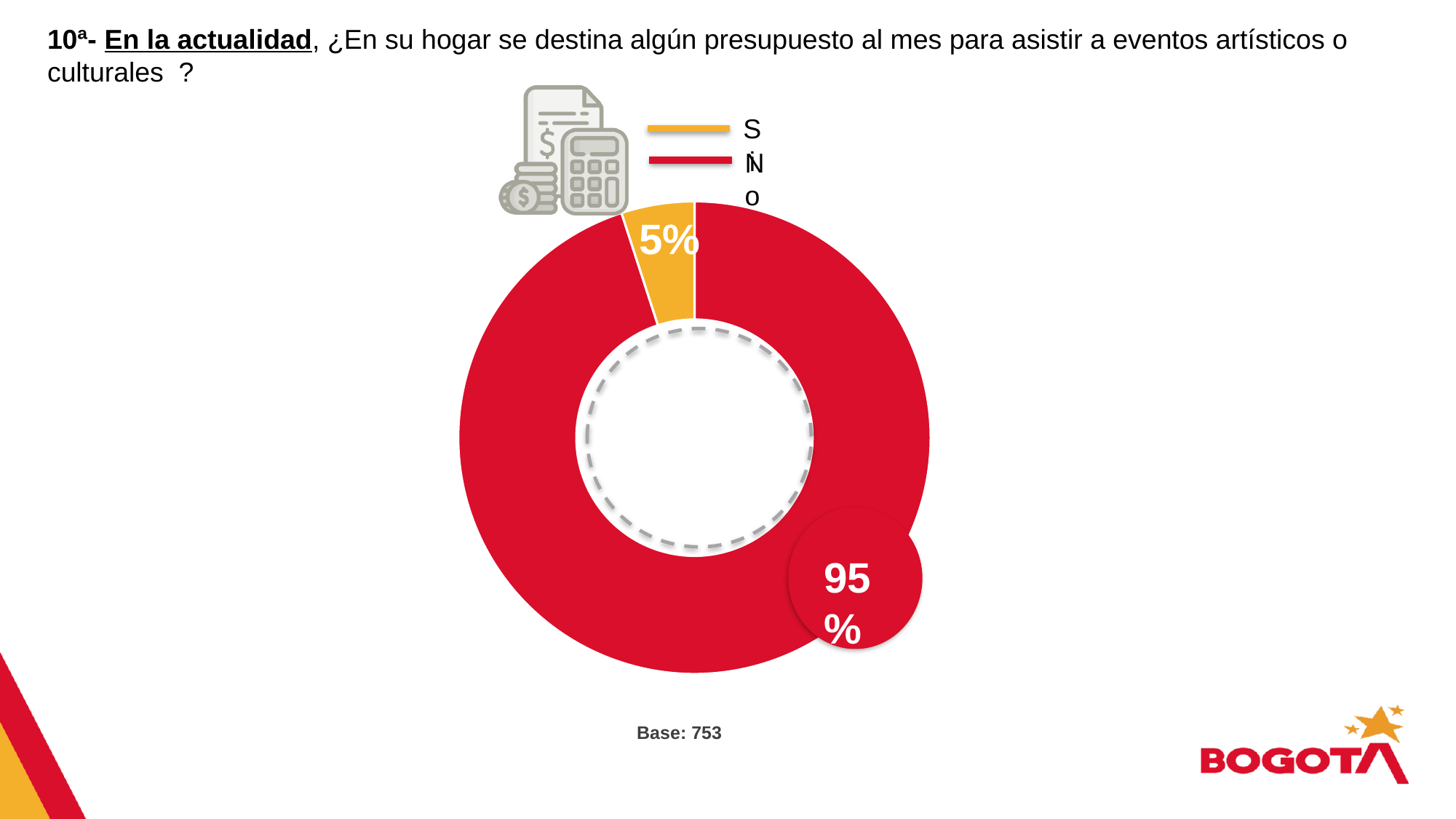
Which response is larger, "Sí" or "No"? No What kind of chart is shown on the slide? Pie (donut) chart How many categories are shown in the chart? 2 What percentage of respondents answered "Sí" in the chart? 5% Which response has the smallest share of the chart? Sí What percentage of respondents answered "No" in the chart? 95% Which response has the largest share of the chart? No What is the difference in percentage points between the "No" and "Sí" responses? 90 What is the base (number of respondents) shown below the chart? 753 How many entries does the legend list? 2 What colour represents the "No" response in the chart? Red